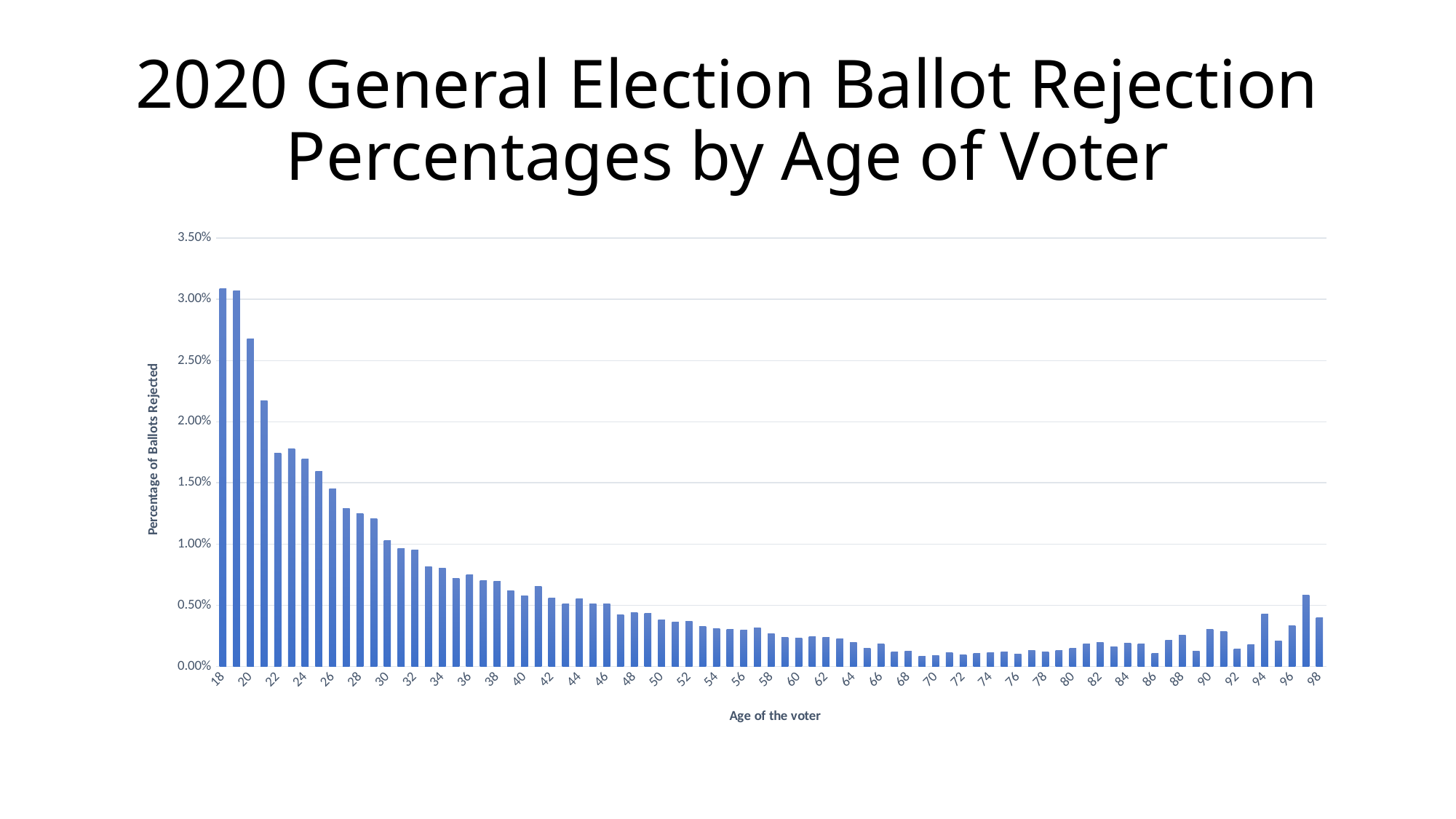
Do the ballot rejection percentages generally rise or fall as age increases from 18 to 70? fall What is the label of the vertical axis? Percentage of Ballots Rejected Is the value for age 20 greater or less than 2.50%? greater Is the value for age 26 greater or less than 1.50%? less Is the value for age 70 greater or less than 0.50%? less Which has a higher ballot rejection percentage, age 20 or age 30? age 20 What kind of chart is shown on the slide? bar chart Which has a higher ballot rejection percentage, age 92 or age 94? age 94 What is the title of the chart on the slide? 2020 General Election Ballot Rejection Percentages by Age of Voter What is the youngest age shown on the x axis? 18